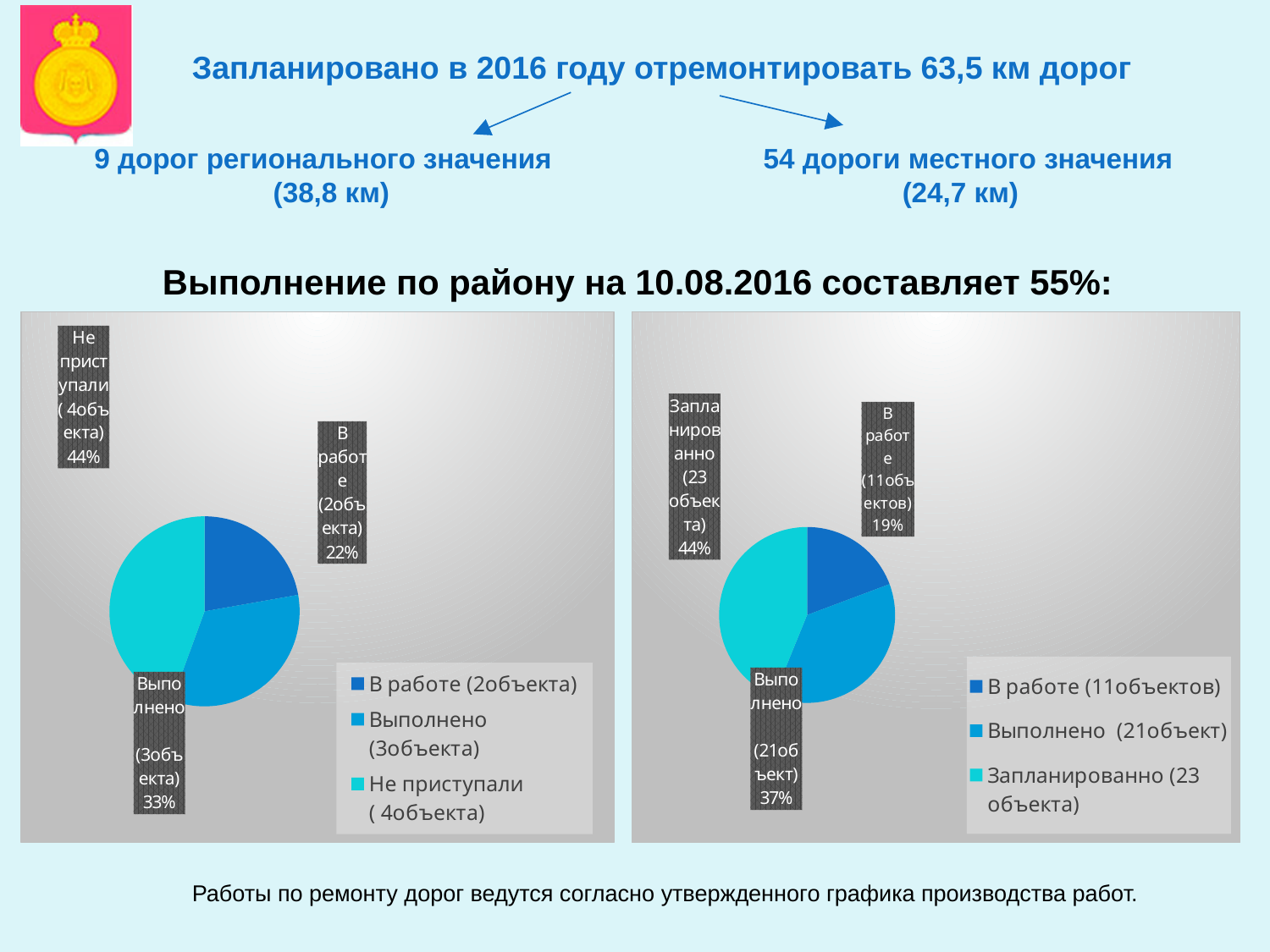
In the left pie chart, what share does the slice 'Выполнено (3объекта)' have? 33% In the left pie chart, which slice is the largest? Не приступали (4объекта) How many entries does the legend of the right pie chart list? 3 In the right pie chart, what is the difference in percentage points between 'Запланированно (23 объекта)' and 'В работе (11объектов)'? 25 In the right pie chart, which slice is the largest? Запланированно (23 объекта) In the right pie chart, what share does the slice 'Выполнено (21объект)' have? 37% In the left pie chart, what share does the slice 'В работе (2объекта)' have? 22% What type of chart is the left chart on the slide? pie chart In the left pie chart, which slice is the smallest? В работе (2объекта) How many slices does the left pie chart have? 3